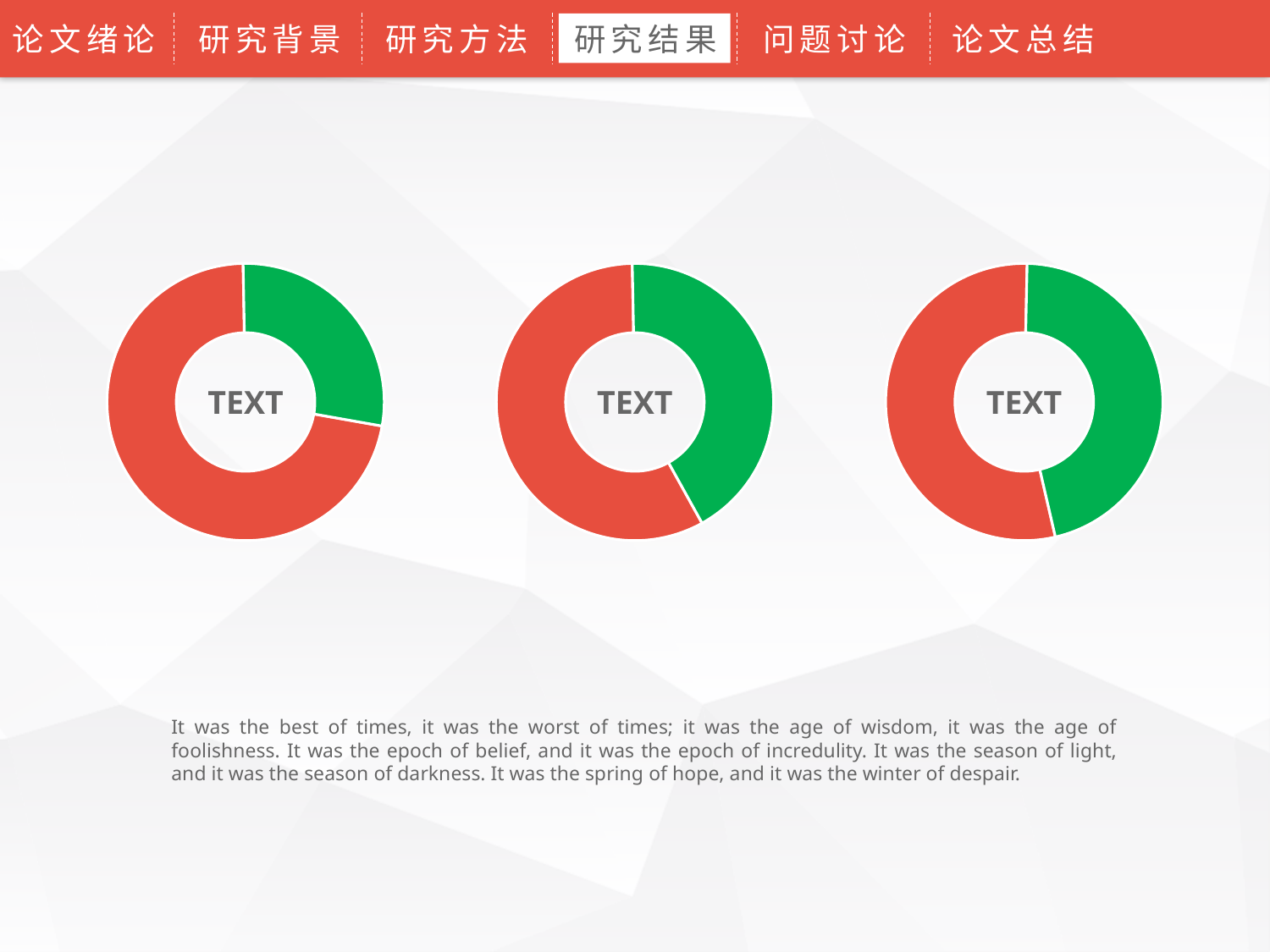
What kind of chart is the middle chart on the slide? donut chart What kind of chart is the left chart on the slide? donut chart How many donut charts are shown on the slide? 3 In the middle donut chart, which slice is larger, the red one or the green one? red What two colours are used for the slices in the donut charts? red and green Of the three donut charts, which one has the smallest green slice? the left chart Of the three donut charts, which one has the largest red slice? the left chart What text is printed in the centre of each donut chart? TEXT In the left donut chart, which slice is larger, the red one or the green one? red How many slices does the left donut chart have? 2 How many slices does the right donut chart have? 2